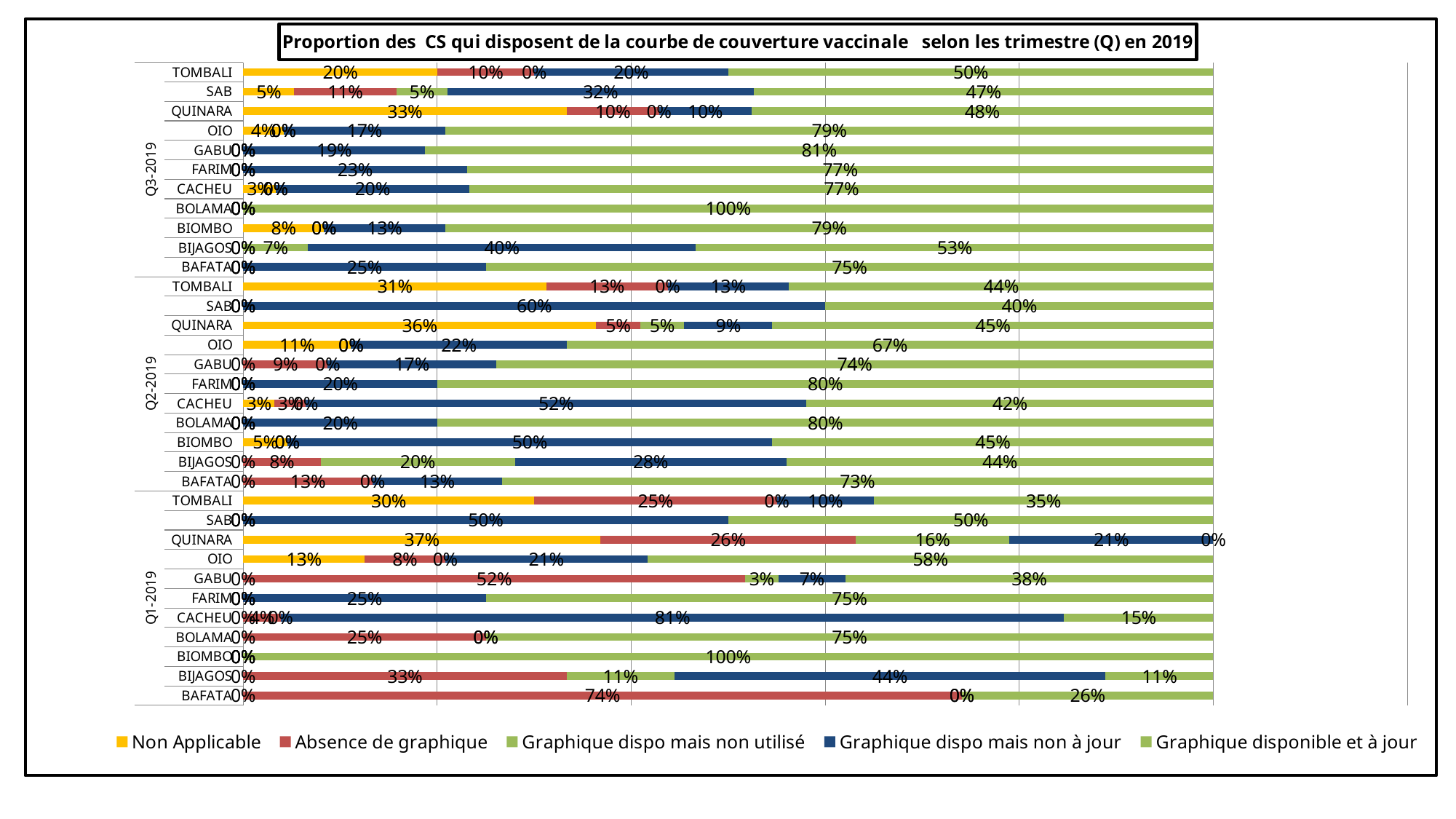
Within the Q1-2019 group, which region has the highest value for 'Absence de graphique'? BAFATA What is the value of 'Graphique disponible et à jour' for BOLAMA in Q3-2019? 100% What is the difference between the 'Graphique disponible et à jour' value for TOMBALI in Q3-2019 (50%) and in Q1-2019 (35%)? 15 percentage points What is the value of 'Graphique dispo mais non à jour' for SAB in Q2-2019? 60% How many series does the legend list? 5 How many quarters (Q groups) are shown on the vertical axis? 3 What is the value of 'Absence de graphique' for BAFATA in Q1-2019? 74% How many regions are listed within the Q3-2019 group? 11 In Q2-2019, which has the larger 'Graphique dispo mais non à jour' value, SAB or CACHEU? SAB What kind of chart is shown on the slide? Stacked bar chart What is the value of 'Non Applicable' for QUINARA in Q1-2019? 37% Within the Q3-2019 group, which region has the highest value for 'Graphique disponible et à jour'? BOLAMA